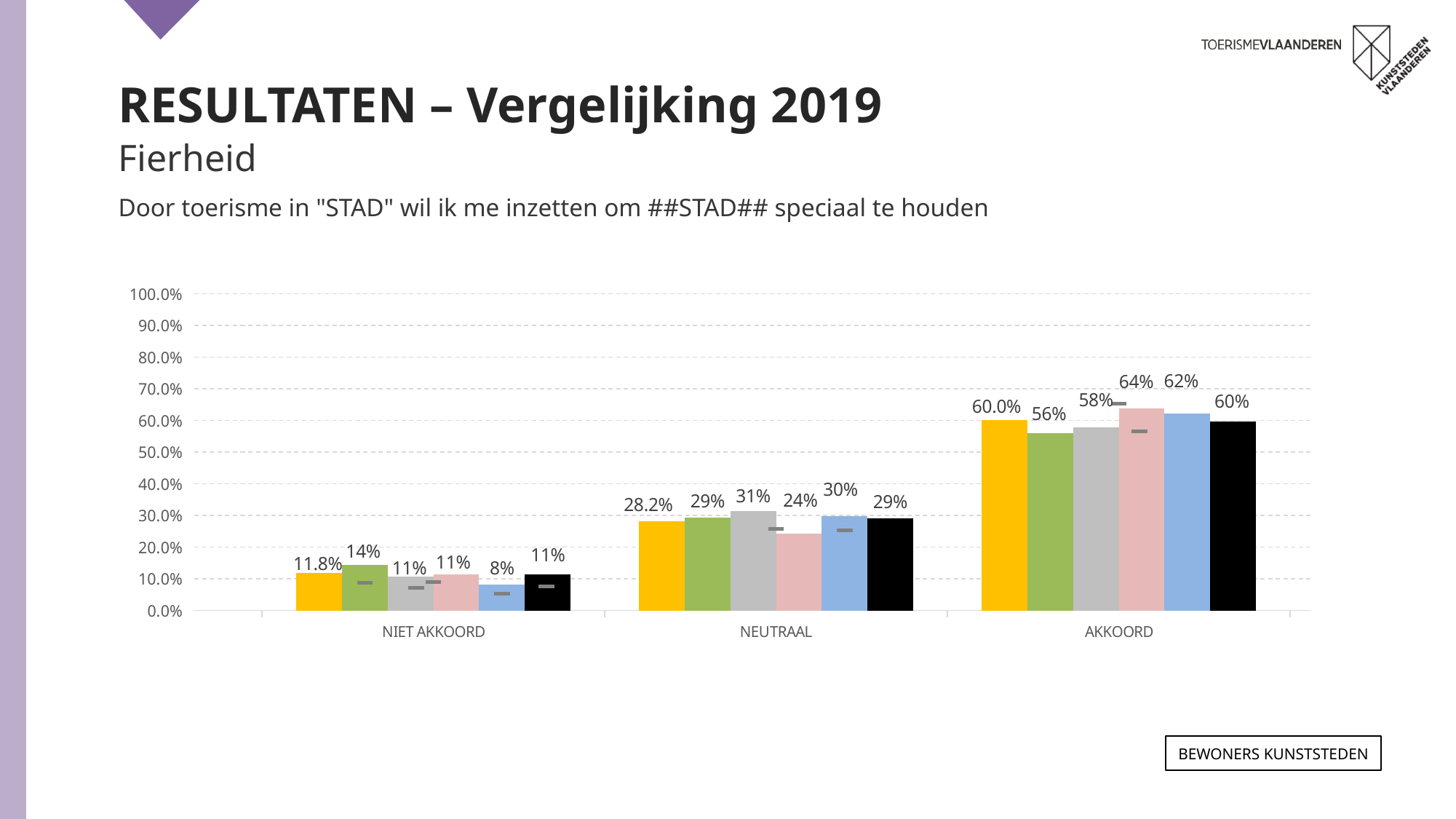
How many bars are shown in each category? 6 What kind of chart is shown on the slide? Bar chart What is the value of the blue bar for NIET AKKOORD? 8% What is the value of the pink bar for AKKOORD? 64% In the NEUTRAAL category, which is larger: the yellow bar or the pink bar? The yellow bar (28.2%) Which category on the x axis has the highest values? AKKOORD What is the difference between the pink bar (64%) and the green bar (56%) in the AKKOORD category? 8 percentage points How many categories are shown on the x axis? 3 Within the NIET AKKOORD category, which coloured bar is the lowest? The blue bar (8%) Is the value of the yellow bar for AKKOORD greater or less than 50%? greater What is the value of the grey bar for NEUTRAAL? 31% What is the value of the yellow bar for NIET AKKOORD? 11.8%